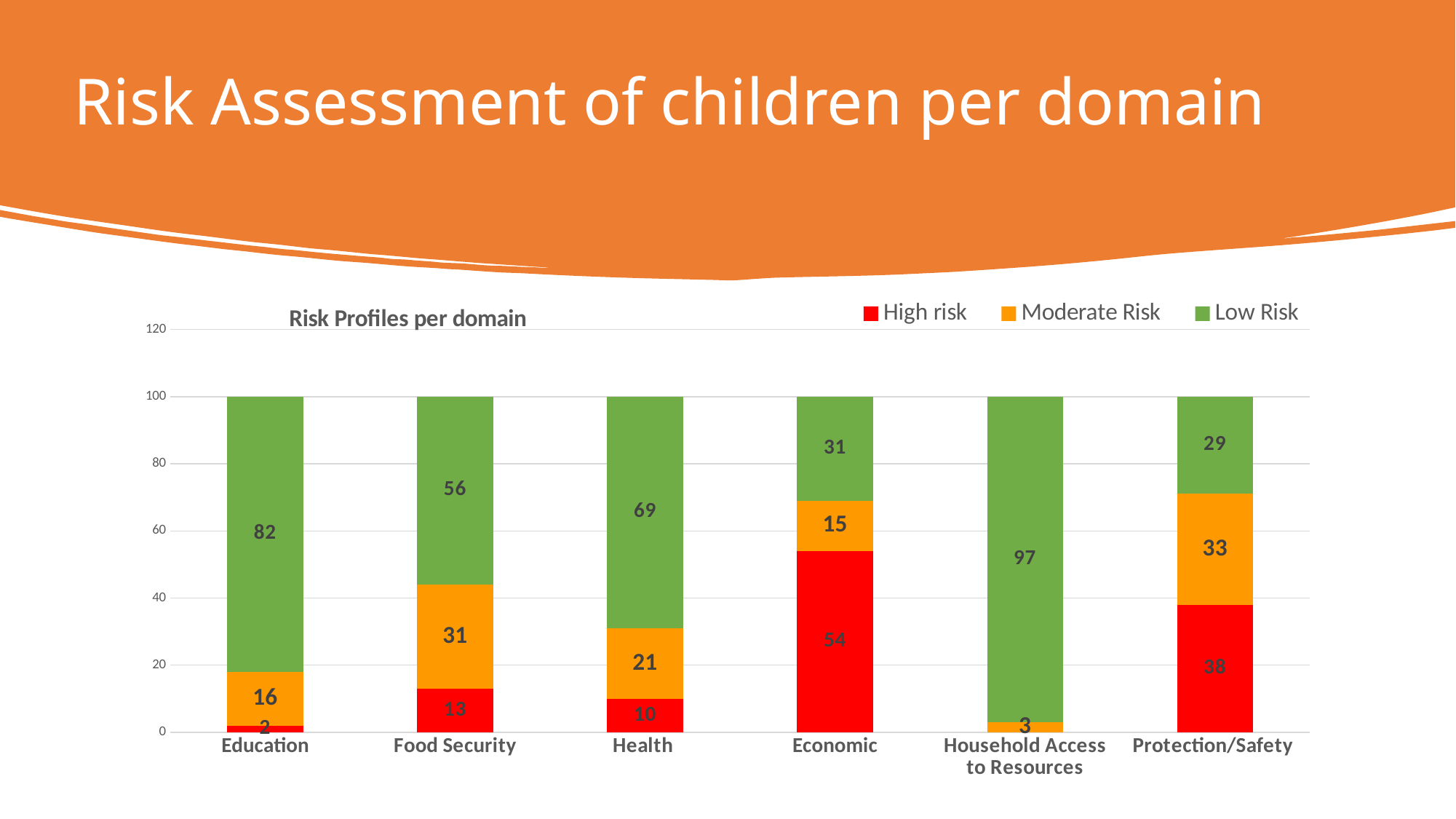
How many domains are shown on the x axis? 6 What is the title of the chart? Risk Profiles per domain What is the Moderate Risk value for Protection/Safety? 33 Which is larger, the High risk value for Economic or for Protection/Safety? Economic How many series does the legend list? 3 What is the total of the stacked bar for Food Security? 100 What kind of chart is shown? Stacked bar chart What is the difference between the Low Risk values for Health and Food Security? 13 Which domain has the highest Low Risk value? Household Access to Resources Which domain has the lowest Moderate Risk value? Household Access to Resources What is the High risk value for Economic? 54 What is the Low Risk value for Education? 82